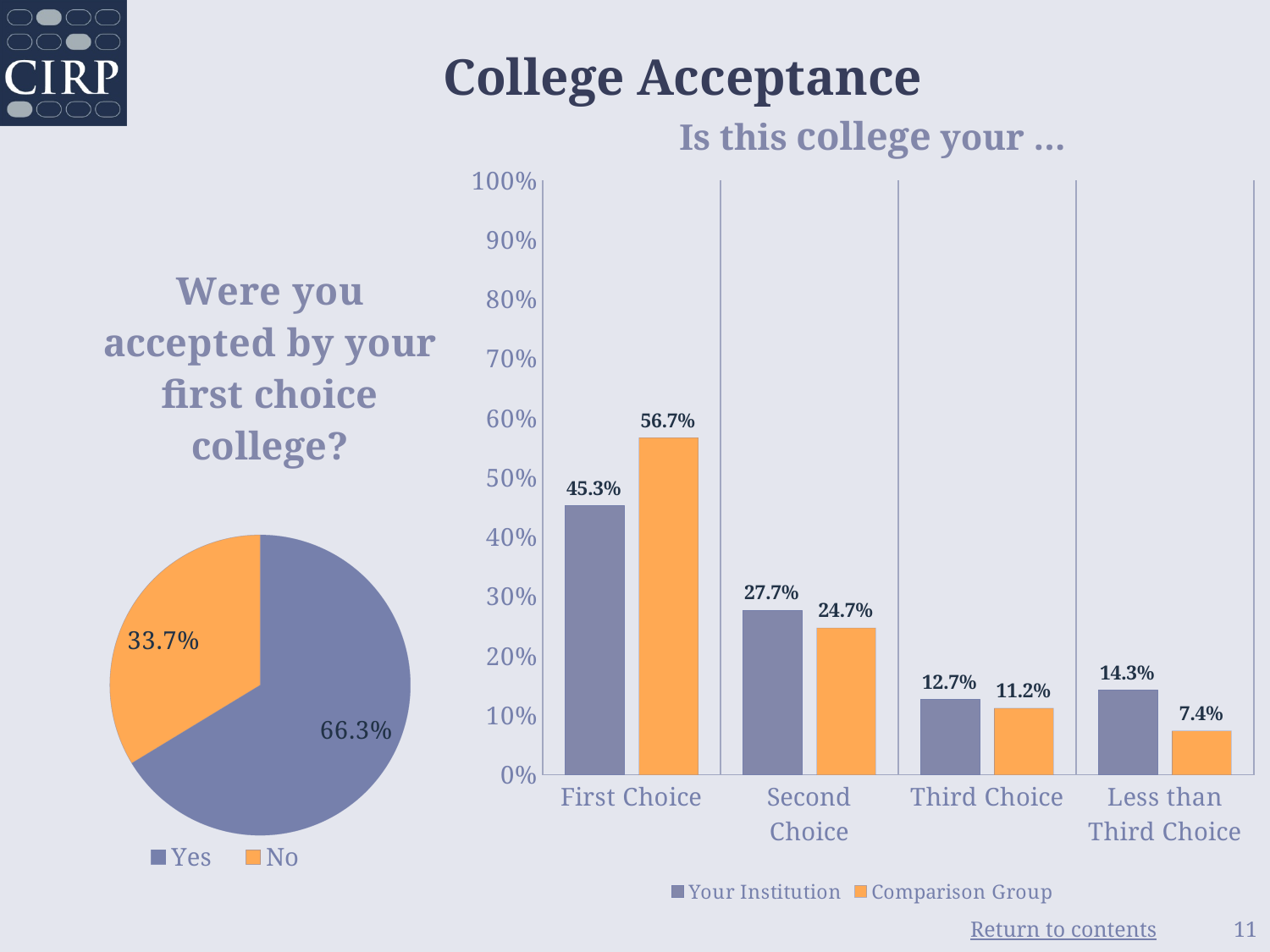
What kind of chart is the chart on the right side of the slide? Bar chart In the bar chart 'Is this college your ...', which category has the highest value for Comparison Group? First Choice In the bar chart 'Is this college your ...', what is the difference between Comparison Group and Your Institution for First Choice? 11.4% In the bar chart 'Is this college your ...', how many series does the legend list? 2 In the bar chart 'Is this college your ...', what is the value for Comparison Group for Less than Third Choice? 7.4% In the pie chart 'Were you accepted by your first choice college?', what percentage answered Yes? 66.3% In the pie chart 'Were you accepted by your first choice college?', how many slices are there? 2 In the bar chart 'Is this college your ...', which is larger for Second Choice, Your Institution or Comparison Group? Your Institution In the pie chart 'Were you accepted by your first choice college?', which slice is larger, Yes or No? Yes In the bar chart 'Is this college your ...', which category has the lowest value for Your Institution? Third Choice In the bar chart 'Is this college your ...', what is the value for Your Institution for First Choice? 45.3% In the pie chart 'Were you accepted by your first choice college?', what percentage answered No? 33.7%